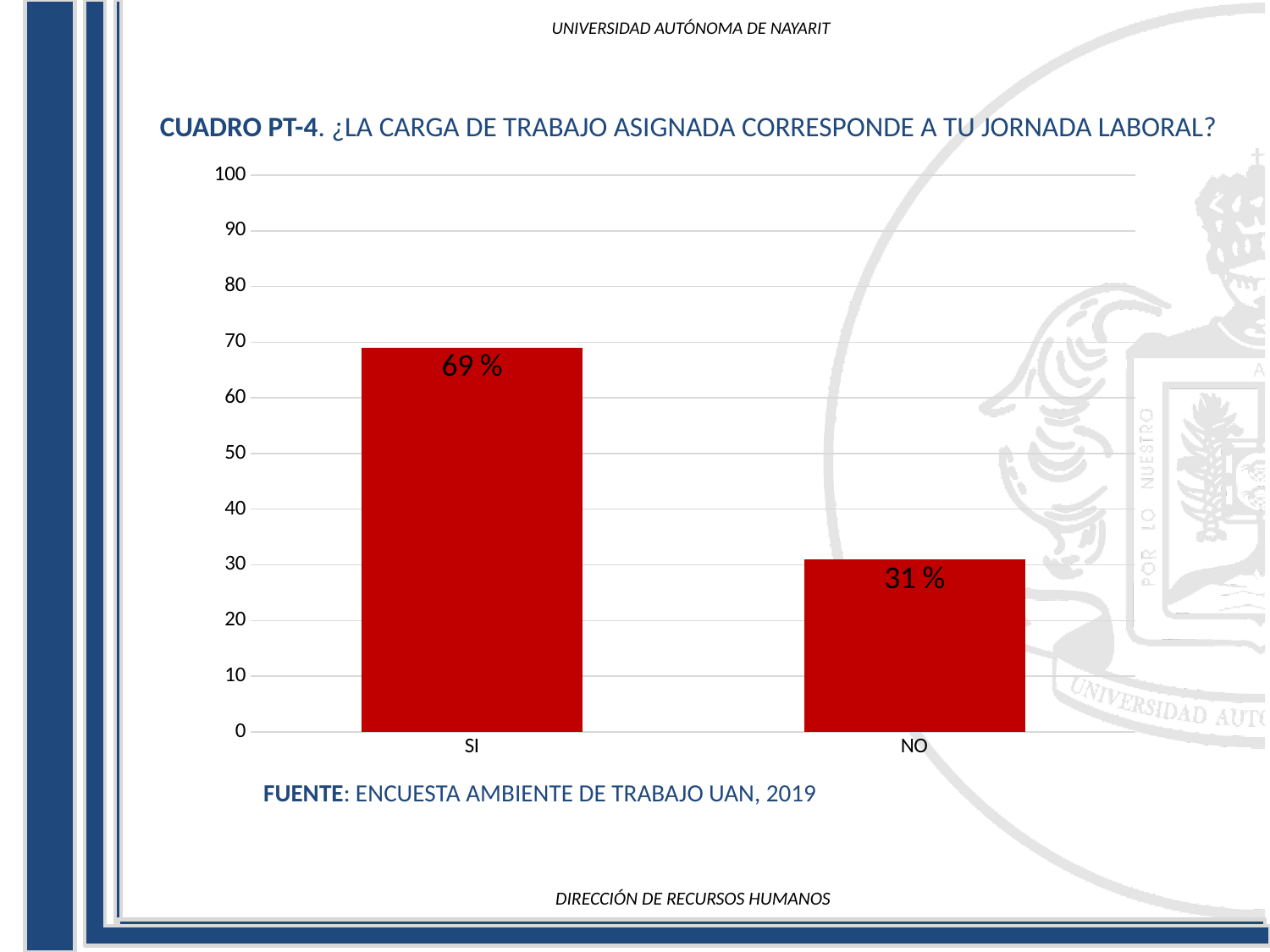
Is the value for SI greater or less than 60? greater Which category has the lowest value? NO What is the difference between the values for SI and NO? 38 % What kind of chart is shown on the slide? bar chart What source is cited below the chart? ENCUESTA AMBIENTE DE TRABAJO UAN, 2019 What is the value for SI? 69 % What is the maximum value shown on the y axis? 100 How many categories are shown on the x axis? 2 Is the value for NO greater or less than 40? less Which is larger, the value for SI or the value for NO? SI What is the value for NO? 31 % Which category has the highest value? SI